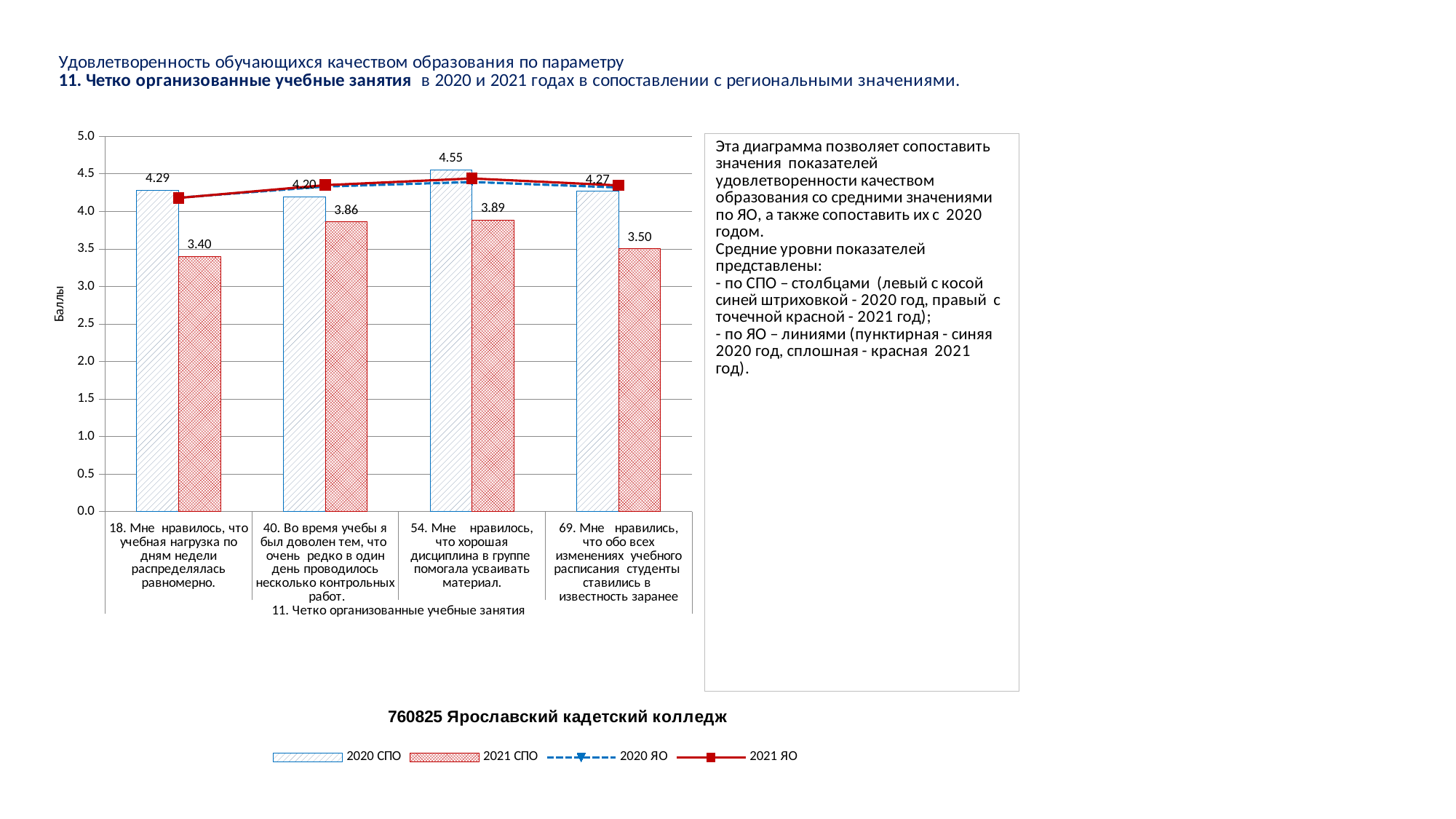
What is the 2021 СПО value for category 40 ("Во время учебы я был доволен тем, что очень редко в один день проводилось несколько контрольных работ")? 3.86 How many categories (questions) are shown on the x axis? 4 Which category has the highest 2020 СПО value? 54. Мне нравилось, что хорошая дисциплина в группе помогала усваивать материал. How many series does the legend list? 4 Is the 2021 ЯО value for category 18 greater or less than 4.0? greater Which category has the lowest 2021 СПО value? 18. Мне нравилось, что учебная нагрузка по дням недели распределялась равномерно. What kind of chart is shown on the slide? Combined bar and line chart What is the 2021 СПО value for category 18 ("Мне нравилось, что учебная нагрузка по дням недели распределялась равномерно")? 3.40 Which is larger for category 54: the 2020 СПО value or the 2021 СПО value? 2020 СПО What is the 2020 СПО value for category 54 ("Мне нравилось, что хорошая дисциплина в группе помогала усваивать материал")? 4.55 What is the difference between the 2020 СПО and 2021 СПО values for category 69 ("Мне нравились, что обо всех изменениях учебного расписания студенты ставились в известность заранее")? 0.77 What is the label of the vertical axis? Баллы